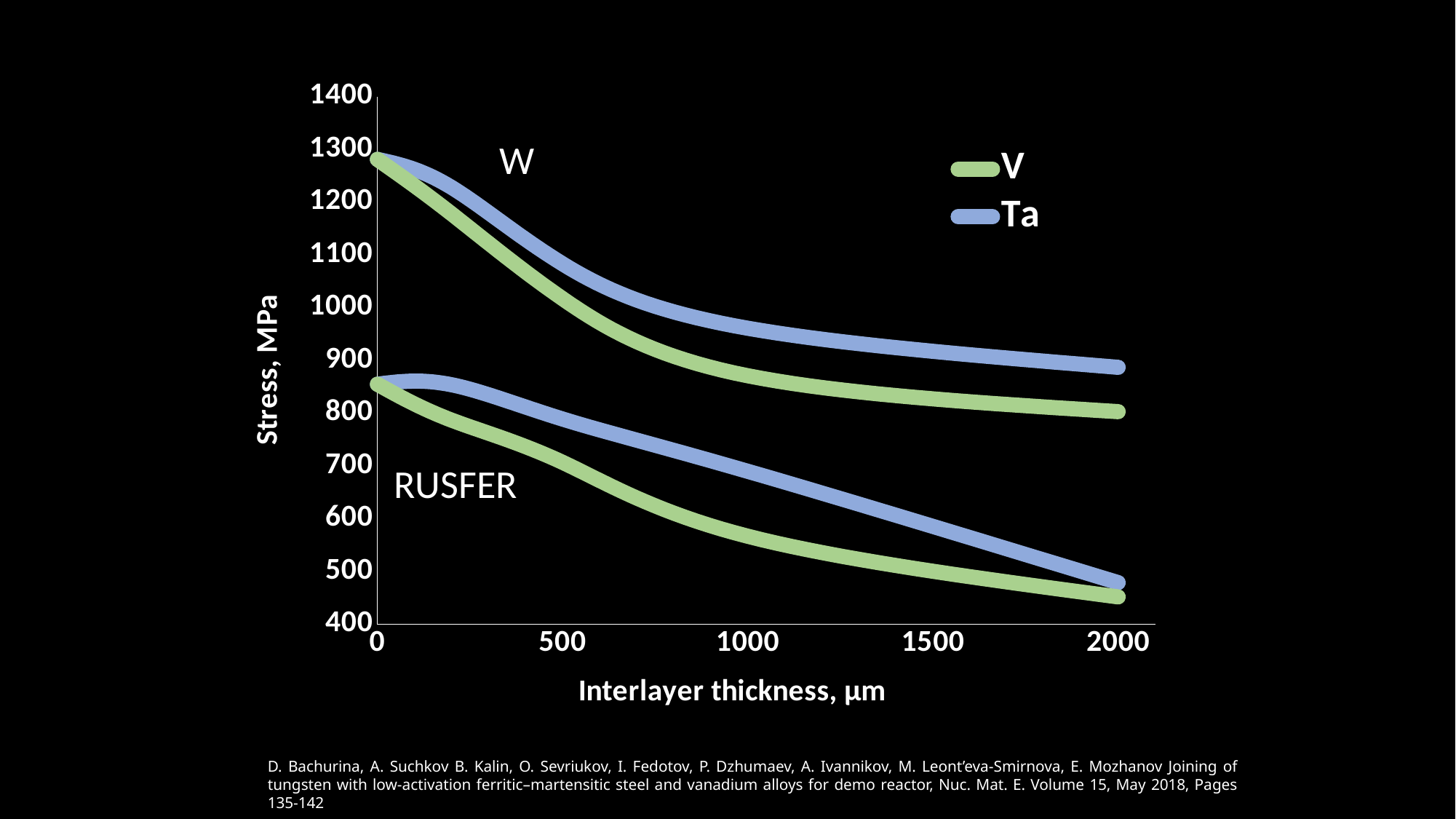
Is the stress for the W curves at 0 µm greater or less than 1200? greater Is the stress for the RUSFER V curve at 1000 µm greater or less than 600? less Is the stress for the W Ta curve at 1000 µm greater or less than 900? greater At 1000 µm, which group of curves shows higher stress, W or RUSFER? W What kind of chart is shown on the slide? line chart How many series does the legend list? 2 Do the stress values rise or fall as interlayer thickness increases along the x axis? fall What is the title of the y axis? Stress, MPa At 1000 µm, which W curve shows the higher stress, V or Ta? Ta Which two series are listed in the legend? V and Ta